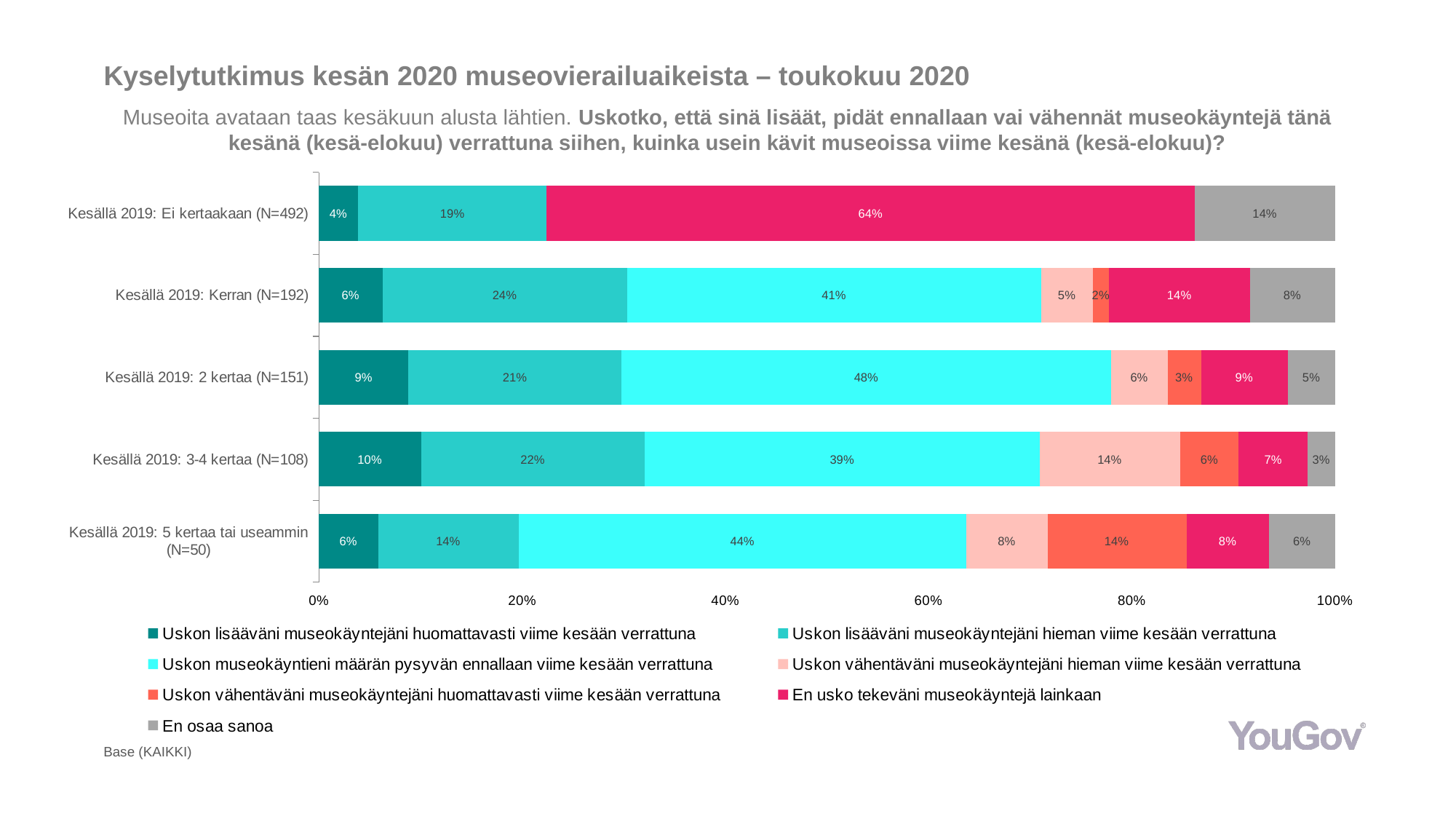
Which group has a larger share of 'Uskon museokäyntieni määrän pysyvän ennallaan viime kesään verrattuna': 'Kesällä 2019: Kerran (N=192)' or 'Kesällä 2019: 5 kertaa tai useammin (N=50)'? Kesällä 2019: 5 kertaa tai useammin (N=50) Which group has the highest share of 'En usko tekeväni museokäyntejä lainkaan'? Kesällä 2019: Ei kertaakaan (N=492) Which group has the highest share of 'Uskon museokäyntieni määrän pysyvän ennallaan viime kesään verrattuna'? Kesällä 2019: 2 kertaa (N=151) What is the value for 'Uskon vähentäväni museokäyntejäni huomattavasti viime kesään verrattuna' in the 'Kesällä 2019: 5 kertaa tai useammin (N=50)' group? 14% What is the value for 'Uskon museokäyntieni määrän pysyvän ennallaan viime kesään verrattuna' in the 'Kesällä 2019: 2 kertaa (N=151)' group? 48% How many respondent groups (bars) are shown in the chart? 5 What share of the 'Kesällä 2019: 3-4 kertaa (N=108)' group answered 'Uskon lisääväni museokäyntejäni huomattavasti viime kesään verrattuna'? 10% How many series does the legend list? 7 What percentage of respondents in the 'Kesällä 2019: Ei kertaakaan (N=492)' group answered 'En usko tekeväni museokäyntejä lainkaan'? 64% What type of chart is shown on the slide? Stacked bar chart Which group has the lowest share of 'En osaa sanoa'? Kesällä 2019: 3-4 kertaa (N=108) In the 'Kesällä 2019: Ei kertaakaan (N=492)' group, how many percentage points higher is 'En usko tekeväni museokäyntejä lainkaan' than 'En osaa sanoa'? 50 percentage points